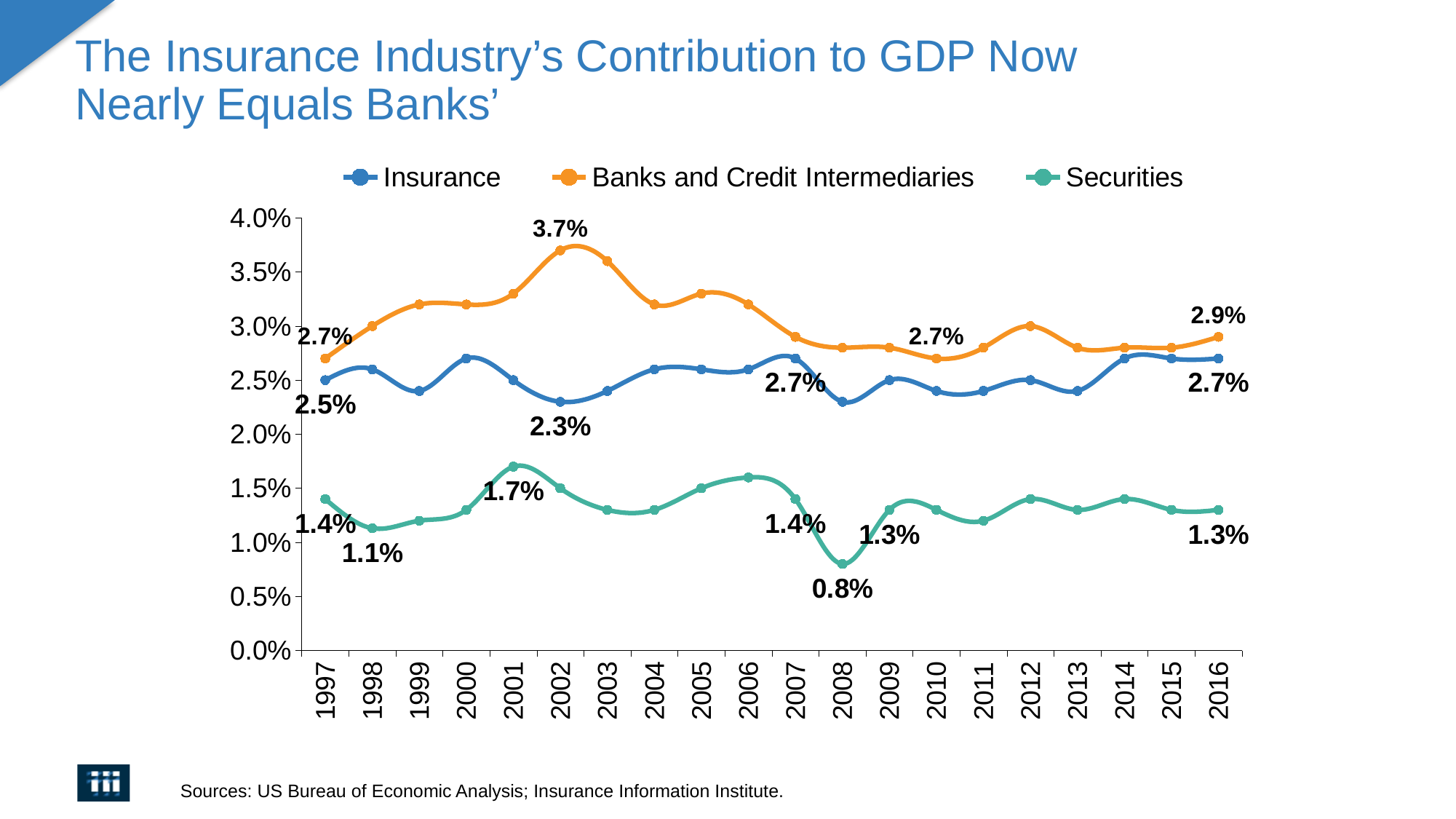
In which year did Securities reach their lowest value? 2008 In which year did Banks and Credit Intermediaries reach their highest value? 2002 Is the Banks and Credit Intermediaries value for 2005 greater or less than 3.0%? greater What was the Banks and Credit Intermediaries contribution to GDP in 2002? 3.7% Which is larger for Insurance: the 1997 value or the 2016 value? 2016 How many years are plotted along the x axis? 20 What was the Securities contribution to GDP in 2008? 0.8% What kind of chart is shown on the slide? Line chart How many series does the legend list? 3 What is the difference between the Securities value in 2001 and in 2008? 0.9 percentage points What was the Insurance contribution to GDP in 2016? 2.7% In 2016, how much higher was the Banks and Credit Intermediaries value than the Insurance value? 0.2 percentage points